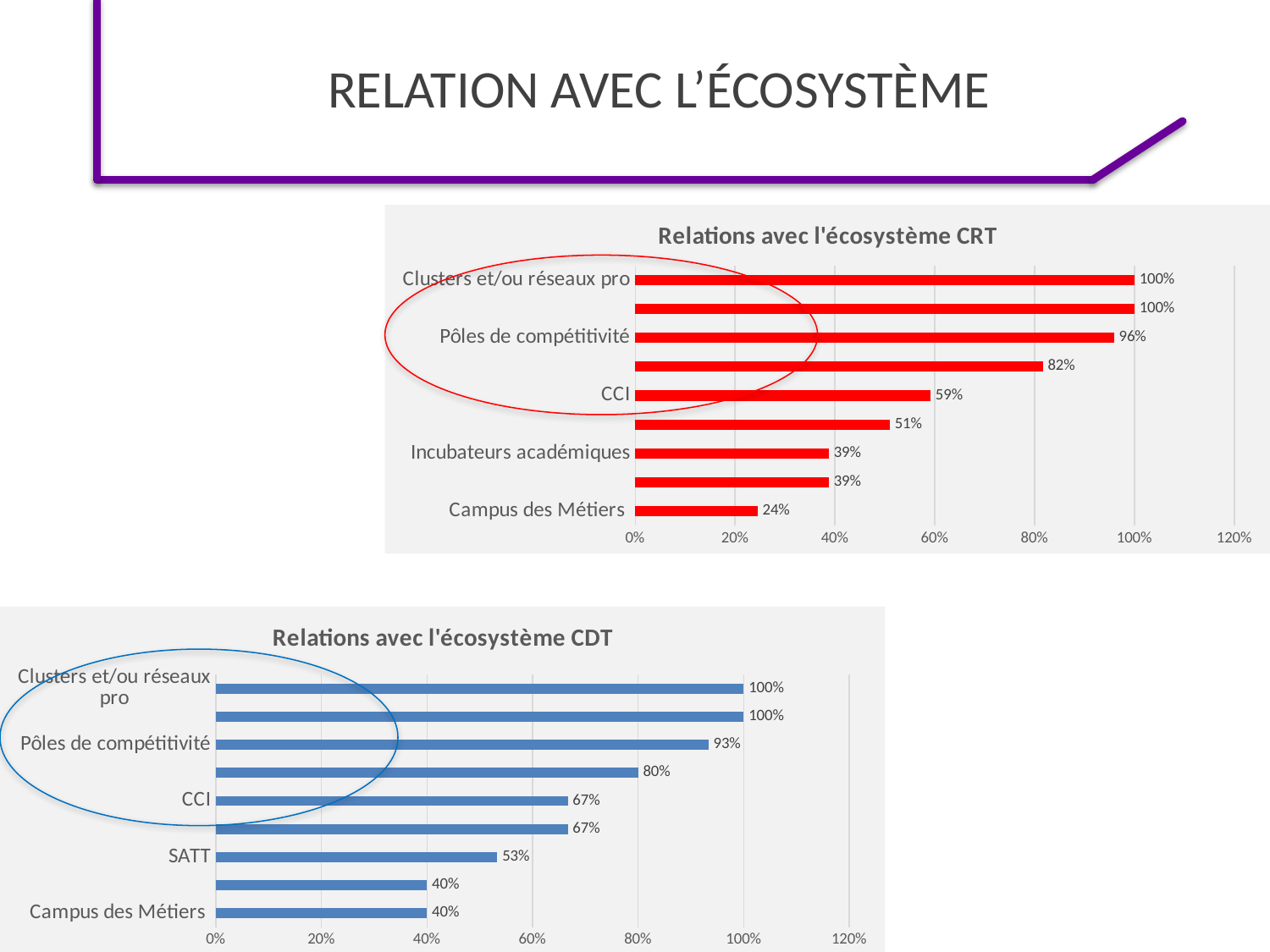
How many bars are plotted in the 'Relations avec l'écosystème CDT' chart? 9 In the 'Relations avec l'écosystème CRT' chart, what is the value for Campus des Métiers? 24% In the 'Relations avec l'écosystème CDT' chart, what is the value for SATT? 53% In the 'Relations avec l'écosystème CDT' chart, what is the value for Campus des Métiers? 40% Which chart shows a higher value for CCI, the CRT chart or the CDT chart? CDT chart In the 'Relations avec l'écosystème CDT' chart, what is the value for Pôles de compétitivité? 93% What type of chart is 'Relations avec l'écosystème CRT'? Bar chart In the 'Relations avec l'écosystème CRT' chart, what is the value for CCI? 59% In the 'Relations avec l'écosystème CDT' chart, which is larger, the value for CCI or the value for SATT? CCI In the 'Relations avec l'écosystème CRT' chart, what is the difference between Clusters et/ou réseaux pro and Incubateurs académiques? 61% In the 'Relations avec l'écosystème CRT' chart, which labelled category has the lowest value? Campus des Métiers In the 'Relations avec l'écosystème CRT' chart, what is the value for Pôles de compétitivité? 96%